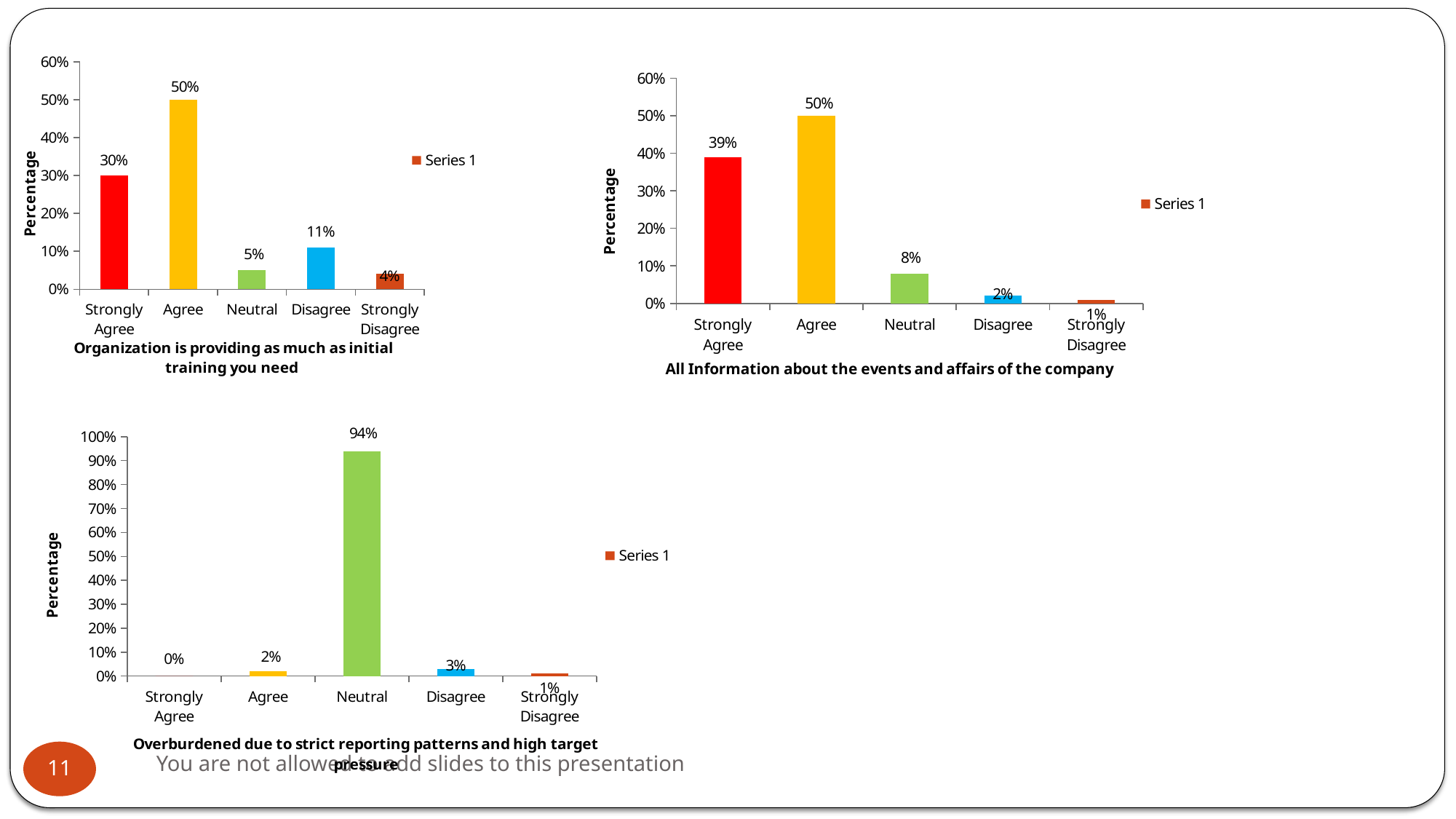
In the 'Overburdened due to strict reporting patterns and high target pressure' chart, what is the difference between Neutral and Disagree? 91% In the 'All Information about the events and affairs of the company' chart, what is the value for Strongly Agree? 39% In the 'Organization is providing as much as initial training you need' chart, which category has the lowest value? Strongly Disagree What type of chart is the 'All Information about the events and affairs of the company' chart? Bar chart In the 'All Information about the events and affairs of the company' chart, which category has the highest value? Agree How many categories are shown on the x axis of the 'Overburdened due to strict reporting patterns and high target pressure' chart? 5 In the 'Overburdened due to strict reporting patterns and high target pressure' chart, what is the value for Neutral? 94% In the 'All Information about the events and affairs of the company' chart, which is larger, Neutral or Disagree? Neutral How many series does the legend of the 'Organization is providing as much as initial training you need' chart list? 1 In the 'Overburdened due to strict reporting patterns and high target pressure' chart, which category has the lowest value? Strongly Agree In the 'Organization is providing as much as initial training you need' chart, what is the difference between Strongly Agree and Disagree? 19% In the 'Organization is providing as much as initial training you need' chart, what is the value for Agree? 50%